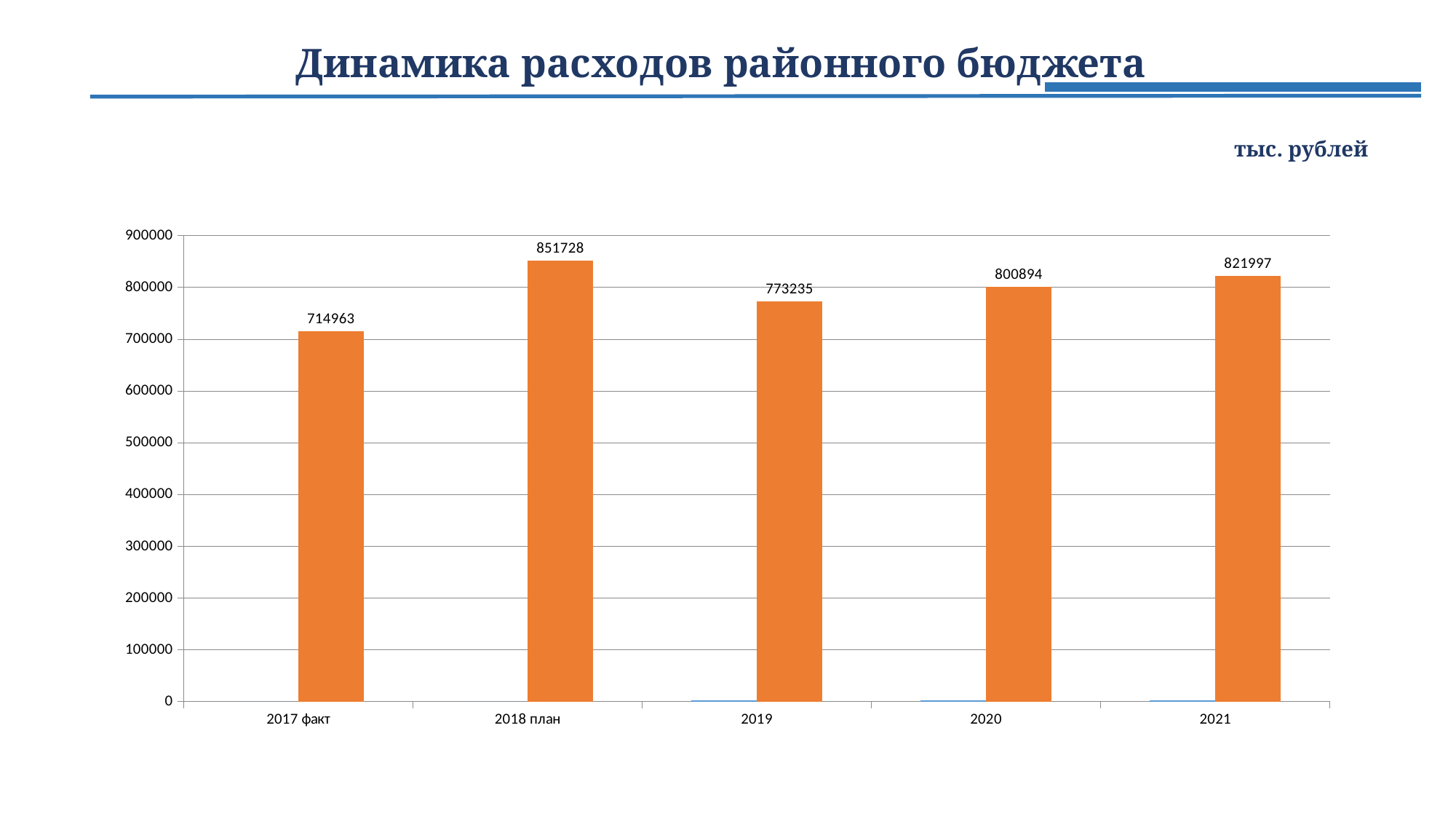
What is the difference between the values for 2021 and 2020? 21103 Which is larger, the value for 2020 or the value for 2019? 2020 What is the difference between the values for 2018 план and 2017 факт? 136765 Which category has the highest value? 2018 план What kind of chart is shown on the slide? bar chart What is the value for 2017 факт? 714963 What is the value for 2021? 821997 What is the value for 2018 план? 851728 Which category has the lowest value? 2017 факт How many categories are shown on the x axis? 5 What is the value for 2019? 773235 Is the value for 2019 greater or less than 800000? less